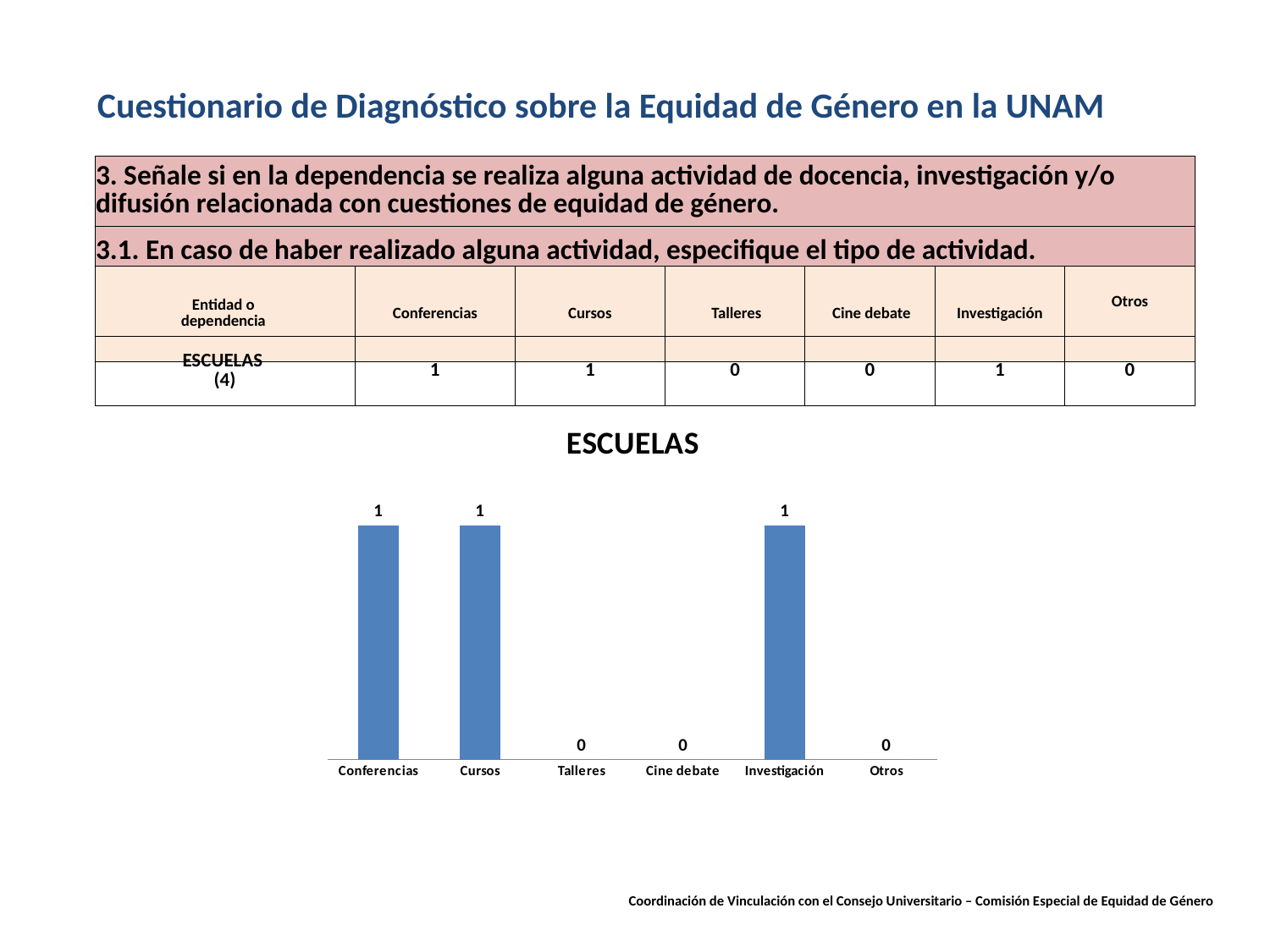
What is the value for Investigación in the ESCUELAS chart? 1 Which is larger in the ESCUELAS chart, Cursos or Talleres? Cursos What kind of chart is the ESCUELAS chart? bar chart What is the value for Talleres in the ESCUELAS chart? 0 What is the value for Conferencias in the ESCUELAS chart? 1 What is the value for Cine debate in the ESCUELAS chart? 0 What colour are the bars in the ESCUELAS chart? blue How many categories are shown on the x axis of the ESCUELAS chart? 6 How many categories in the ESCUELAS chart have a value of 0? 3 What is the title of the chart on the slide? ESCUELAS What is the value for Otros in the ESCUELAS chart? 0 What is the difference between the values for Conferencias and Cine debate in the ESCUELAS chart? 1